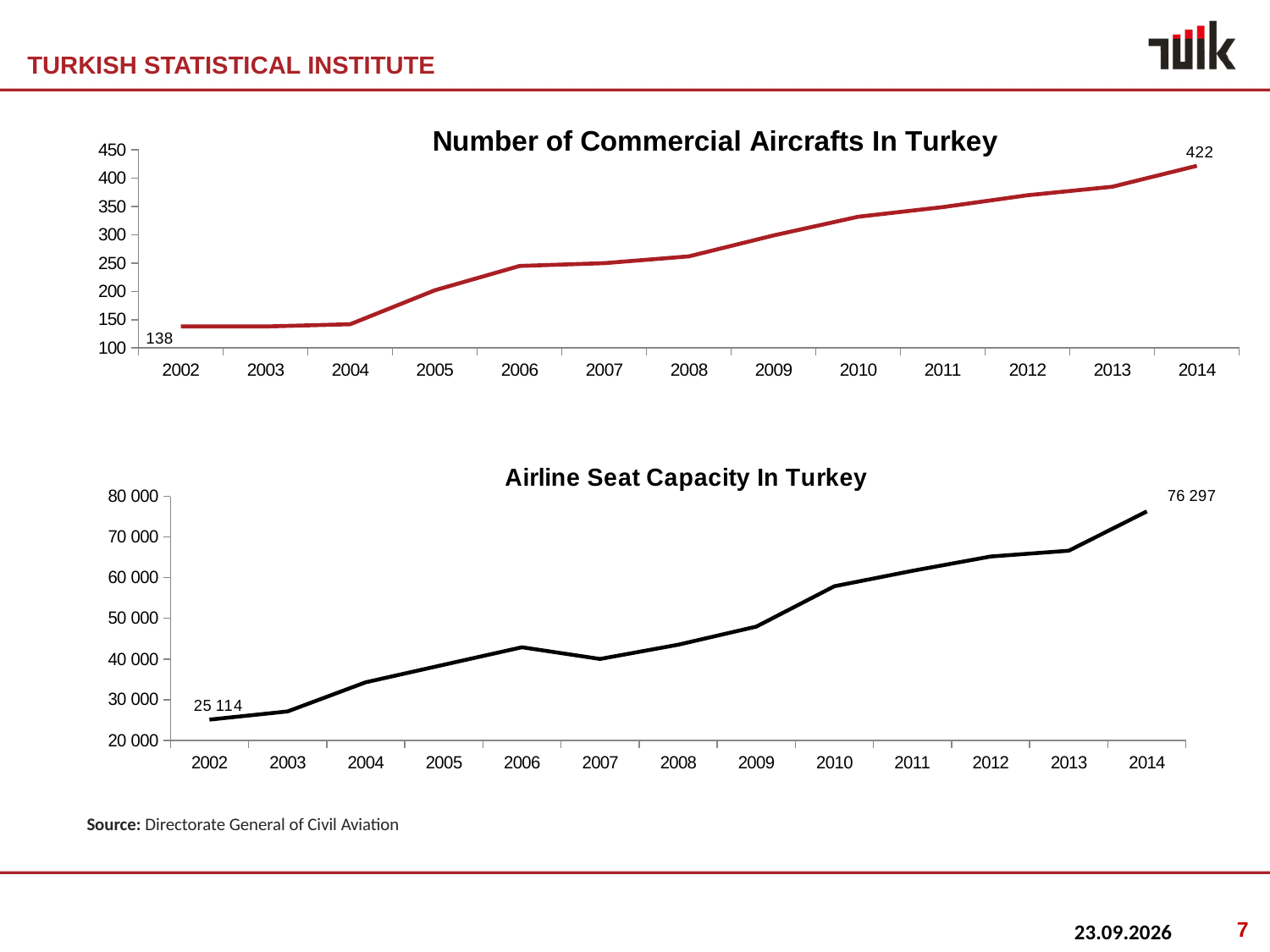
In the 'Airline Seat Capacity In Turkey' chart, is the value for 2007 greater or less than 50 000? less In the 'Airline Seat Capacity In Turkey' chart, which is larger, the value for 2009 or the value for 2010? 2010 In the 'Number of Commercial Aircrafts In Turkey' chart, is the value for 2010 greater or less than 300? greater In the 'Airline Seat Capacity In Turkey' chart, what is the value for 2002? 25 114 In the 'Number of Commercial Aircrafts In Turkey' chart, what is the value for 2002? 138 What type of chart is the 'Airline Seat Capacity In Turkey' chart? Line chart In the 'Airline Seat Capacity In Turkey' chart, what is the value for 2014? 76 297 In the 'Airline Seat Capacity In Turkey' chart, what is the difference between the 2014 and 2002 values? 51 183 In the 'Number of Commercial Aircrafts In Turkey' chart, which year has the highest value? 2014 In the 'Number of Commercial Aircrafts In Turkey' chart, what is the difference between the 2014 and 2002 values? 284 In the 'Number of Commercial Aircrafts In Turkey' chart, what is the value for 2014? 422 In the 'Number of Commercial Aircrafts In Turkey' chart, how many years are plotted on the x axis? 13